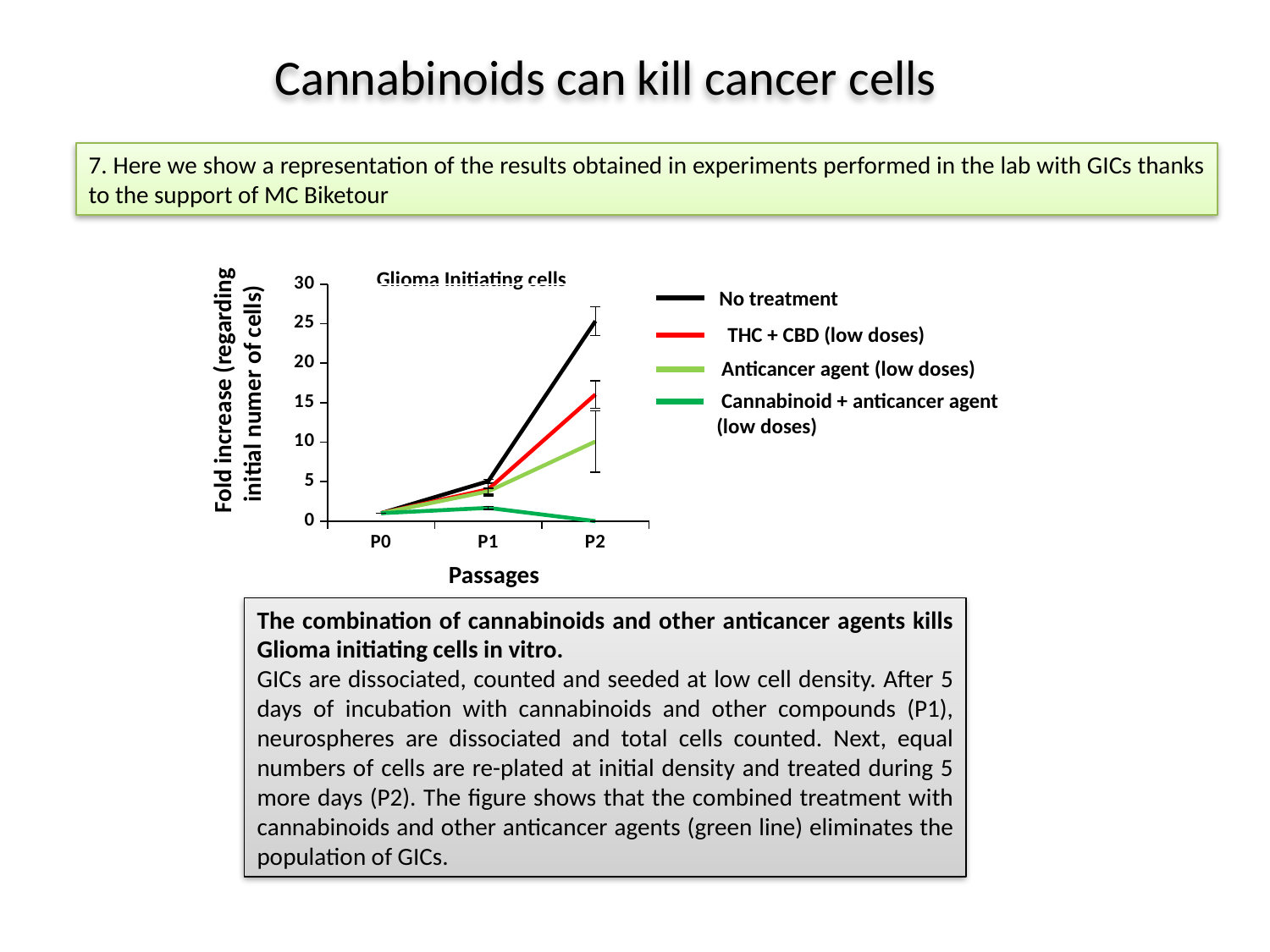
At P2, which is larger: the fold increase for No treatment or for THC + CBD (low doses)? No treatment Is the fold increase for No treatment at P2 greater or less than 20? greater Is the fold increase for THC + CBD (low doses) at P2 greater or less than 10? greater What kind of chart is shown on the slide? line chart Which treatment has the lowest fold increase at P2? Cannabinoid + anticancer agent (low doses) Is the fold increase for Anticancer agent (low doses) at P2 greater or less than 15? less Does the No treatment line rise or fall from P0 to P2? rise What is the label of the x axis? Passages Which treatment has the highest fold increase at P2? No treatment How many passages are shown on the x axis? 3 How many series does the legend list? 4